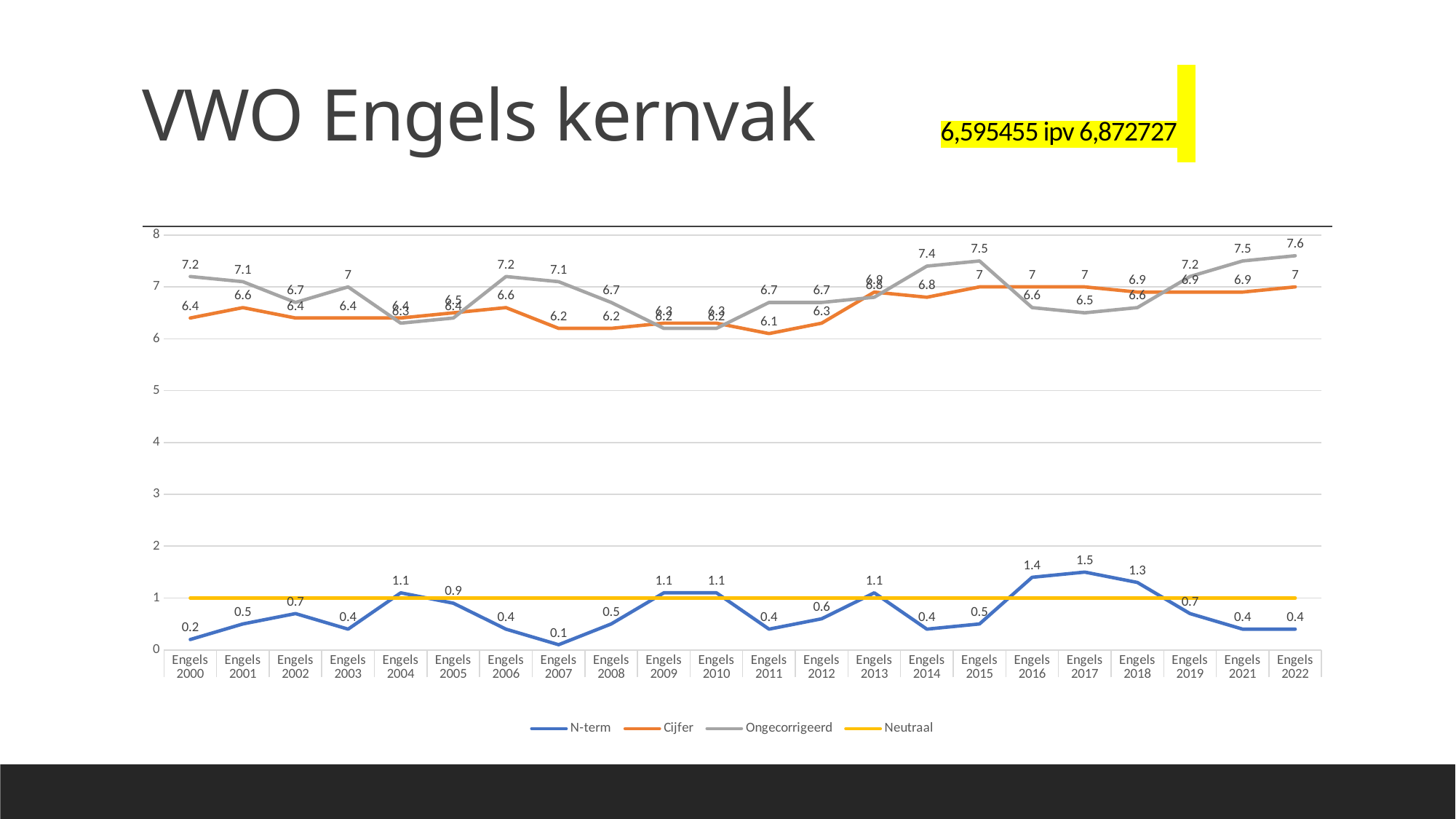
Which series is drawn as a constant horizontal line at 1? Neutraal What is the Ongecorrigeerd value for Engels 2022? 7.6 Which is larger: the Cijfer value for Engels 2001 or for Engels 2011? Engels 2001 How many series does the legend list? 4 In which year is the N-term lowest? Engels 2007 Is the N-term value for Engels 2016 greater or less than 1? greater What kind of chart is shown on the slide? line chart What is the N-term value for Engels 2017? 1.5 In which year is the N-term highest? Engels 2017 How many categories are shown on the x axis? 22 What is the difference between the Ongecorrigeerd value and the Cijfer value for Engels 2000? 0.8 What is the Cijfer value for Engels 2011? 6.1